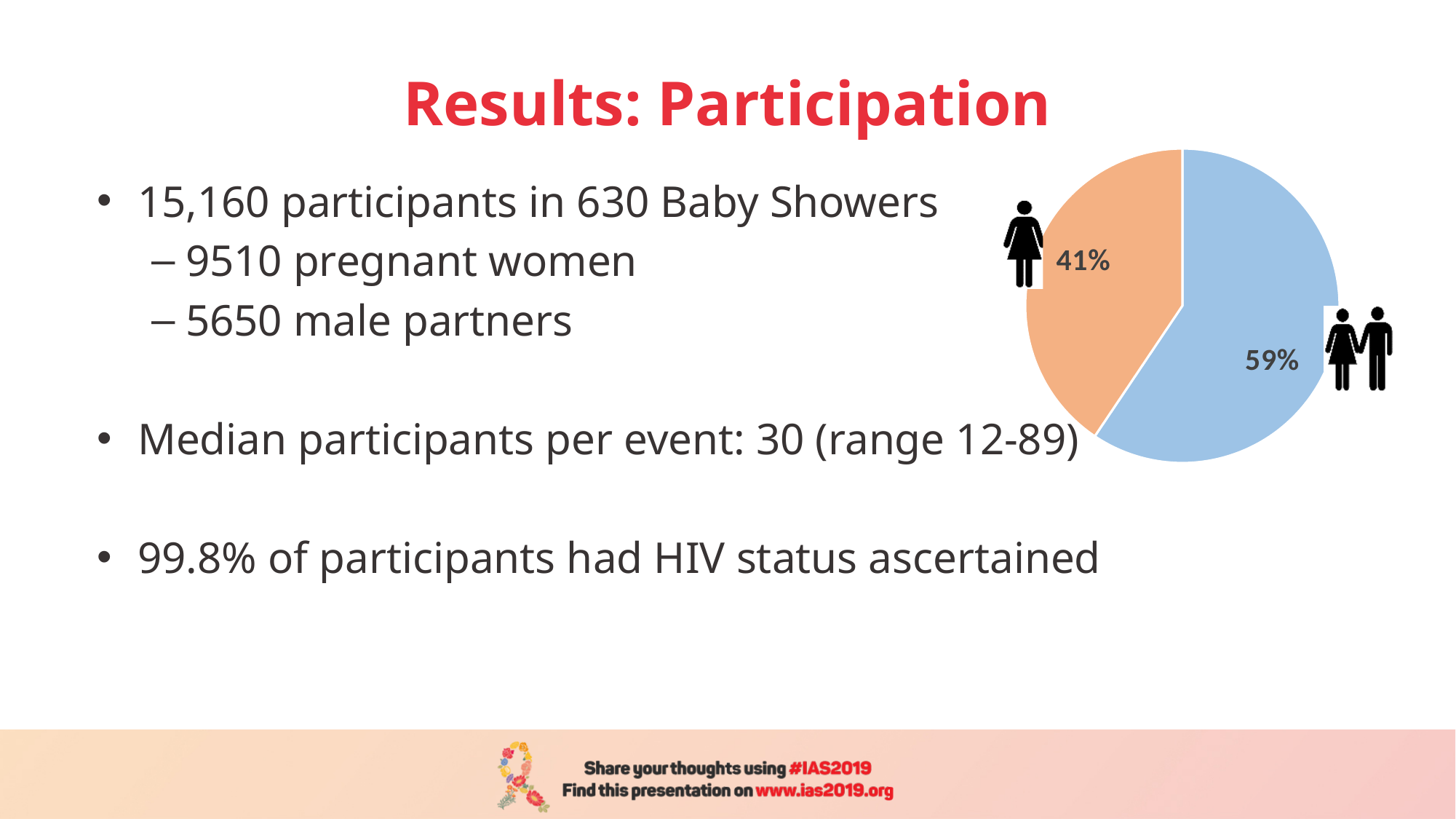
Which slice of the pie chart is the smallest? the orange slice (41%) What colour is the slice labelled 59% in the pie chart? blue How many slices does the pie chart have? 2 What kind of chart is shown on the right of the slide? pie chart Which is larger in the pie chart, the orange slice or the blue slice? the blue slice What share of the pie is marked with the couple icon? 59% Which slice of the pie chart is the largest? the blue slice (59%) What percentage is shown on the blue slice of the pie chart? 59% Is the value of the orange slice in the pie chart greater or less than 50%? less What share of the pie is marked with the single woman icon? 41% What percentage is shown on the orange slice of the pie chart? 41% What is the difference in percentage points between the blue slice and the orange slice of the pie chart? 18